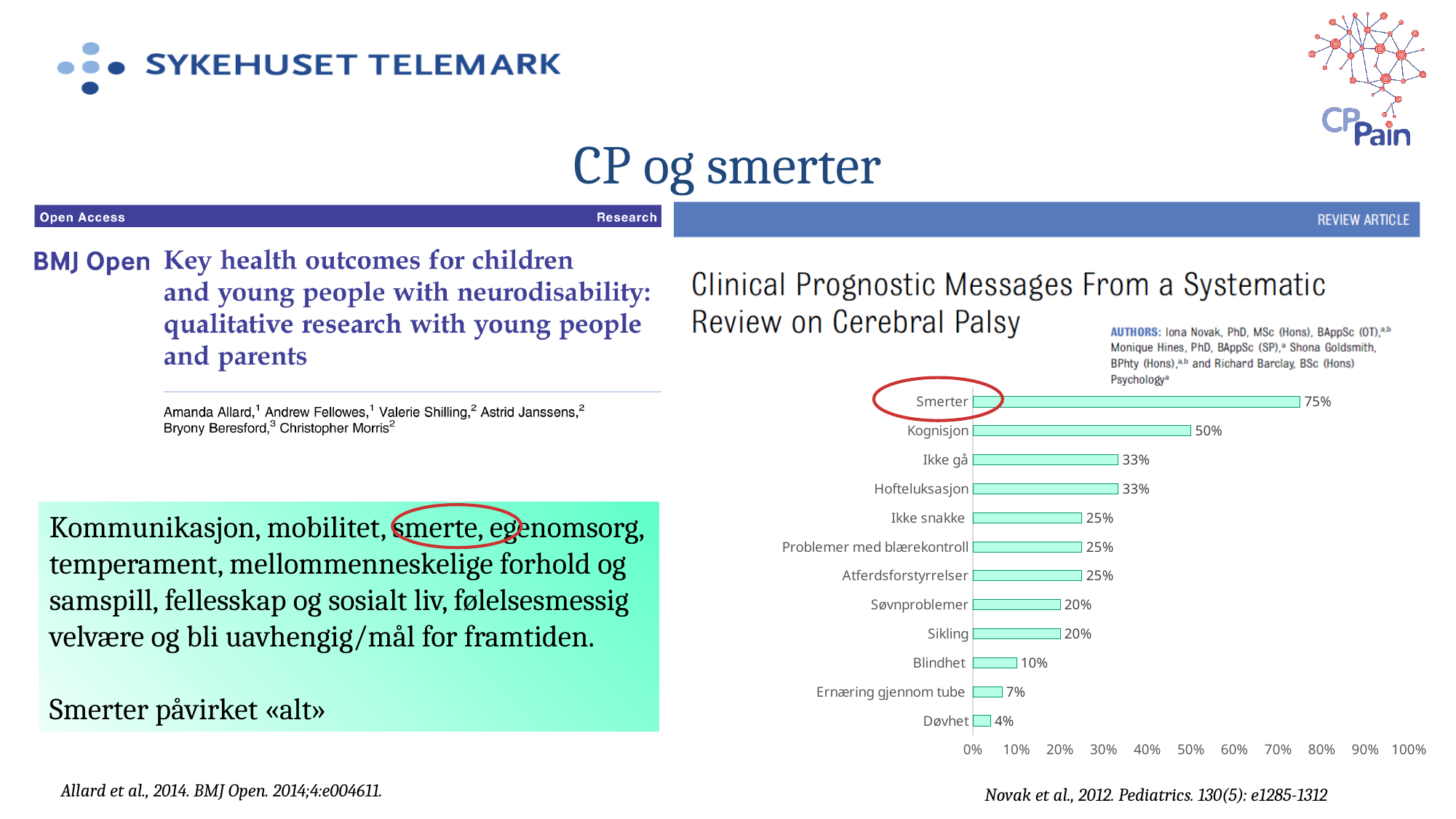
What is the difference between the values for Blindhet and Døvhet? 6% Which category has the highest value in the bar chart? Smerter Which category has the lowest value in the bar chart? Døvhet What is the value for Kognisjon in the bar chart? 50% What is the difference between the values for Smerter and Kognisjon? 25% What kind of chart is shown on the slide? Bar chart What is the value for Ernæring gjennom tube in the bar chart? 7% What is the value for Smerter in the bar chart? 75% Which is larger, the value for Ikke gå or the value for Sikling? Ikke gå Which category in the bar chart is circled in red? Smerter What is the value for Søvnproblemer in the bar chart? 20% How many categories are shown in the bar chart? 12